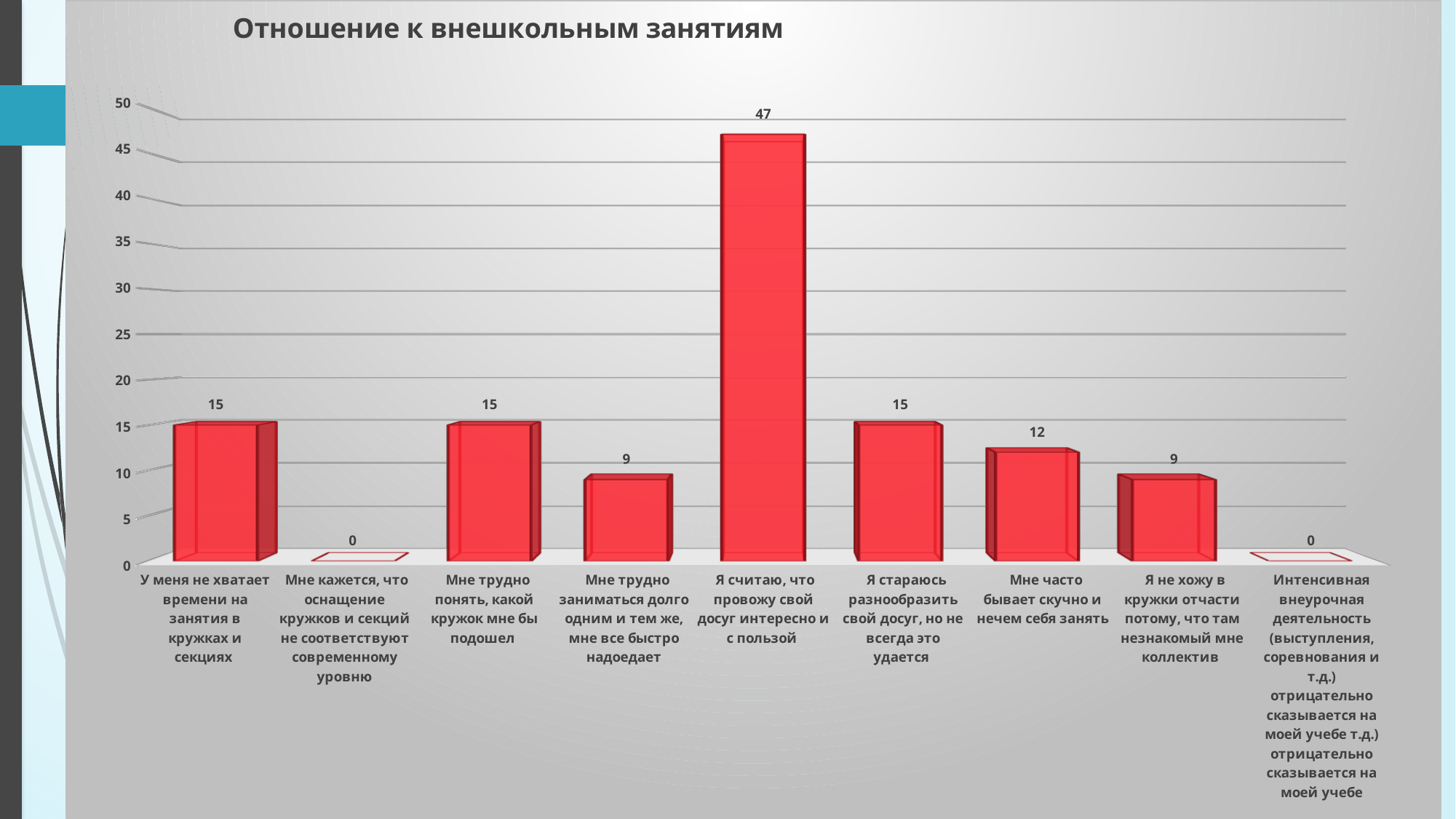
What is the value for "Мне кажется, что оснащение кружков и секций не соответствуют современному уровню"? 0 Which is larger: the value for "Я стараюсь разнообразить свой досуг, но не всегда это удается" or the value for "Мне часто бывает скучно и нечем себя занять"? Я стараюсь разнообразить свой досуг, но не всегда это удается What is the value for "Мне трудно заниматься долго одним и тем же, мне все быстро надоедает"? 9 What is the difference between the value for "Мне часто бывает скучно и нечем себя занять" and the value for "Я не хожу в кружки отчасти потому, что там незнакомый мне коллектив"? 3 Is the value for "Я считаю, что провожу свой досуг интересно и с пользой" greater or less than 40? greater How many categories are shown on the x axis? 9 What is the difference between the value for "Я считаю, что провожу свой досуг интересно и с пользой" and the value for "У меня не хватает времени на занятия в кружках и секциях"? 32 Which category has the highest value? Я считаю, что провожу свой досуг интересно и с пользой What is the value for "Мне часто бывает скучно и нечем себя занять"? 12 What kind of chart is shown on the slide? bar chart What is the title of the chart? Отношение к внешкольным занятиям What is the value for "Я считаю, что провожу свой досуг интересно и с пользой"? 47